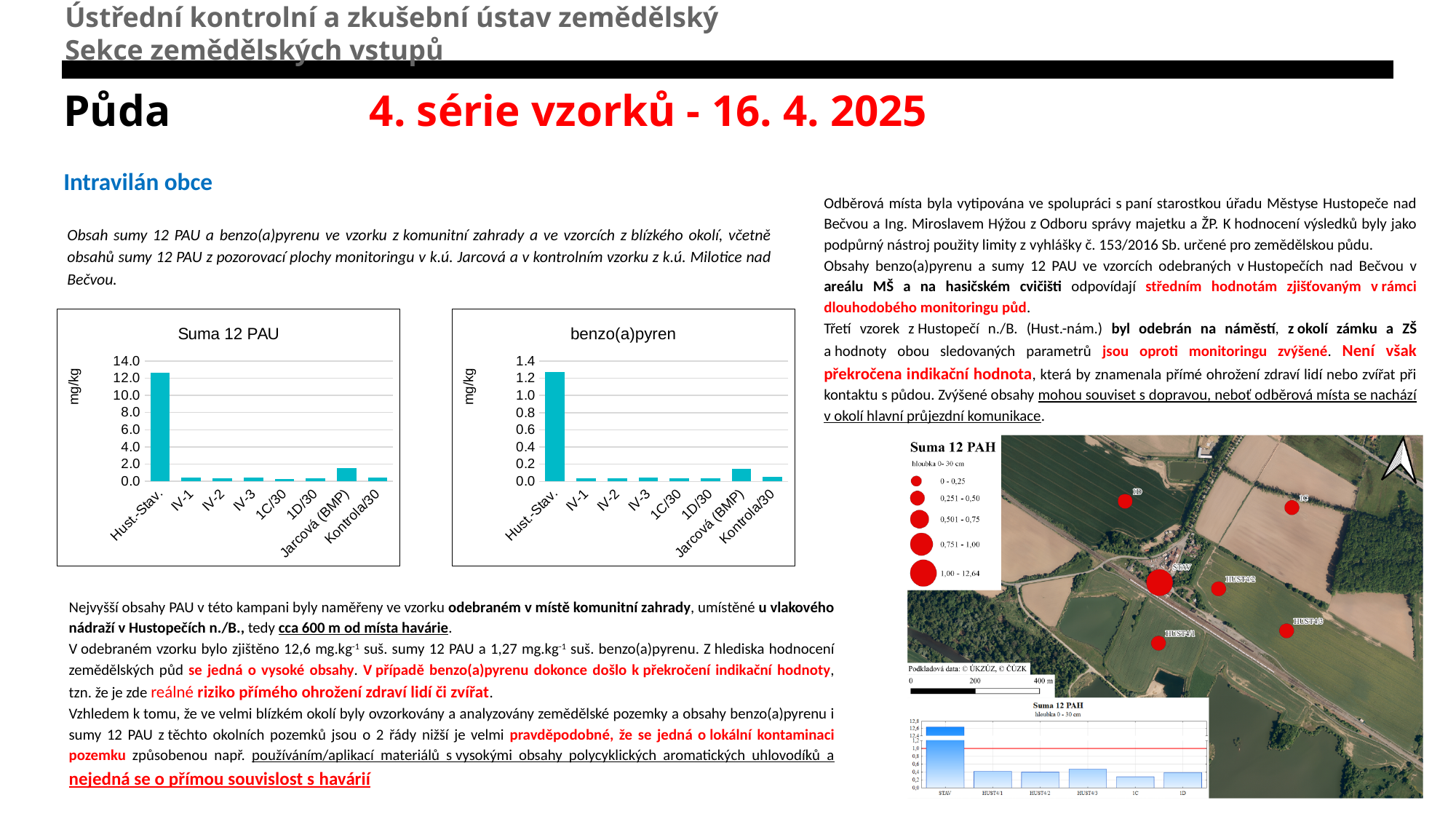
In the "benzo(a)pyren" chart, which is larger: the value for Jarcová (BMP) or the value for Kontrola/30? Jarcová (BMP) In the "Suma 12 PAU" chart, which is larger: the value for Jarcová (BMP) or the value for IV-1? Jarcová (BMP) In the "benzo(a)pyren" chart, which category has the highest value? Hust.-Stav. What kind of chart is the "Suma 12 PAU" chart? bar chart How many categories are shown on the x axis of the "benzo(a)pyren" chart? 8 What is the title of the right-hand bar chart on the left side of the slide? benzo(a)pyren In the "benzo(a)pyren" chart, is the value for Jarcová (BMP) greater or less than 0.4? less What unit is shown on the y axis of the "Suma 12 PAU" chart? mg/kg In the "Suma 12 PAU" chart, is the value for Jarcová (BMP) greater or less than 2.0? less In the "Suma 12 PAU" chart, is the value for Hust.-Stav. greater or less than 10.0? greater In the "Suma 12 PAU" chart, which category has the highest value? Hust.-Stav.